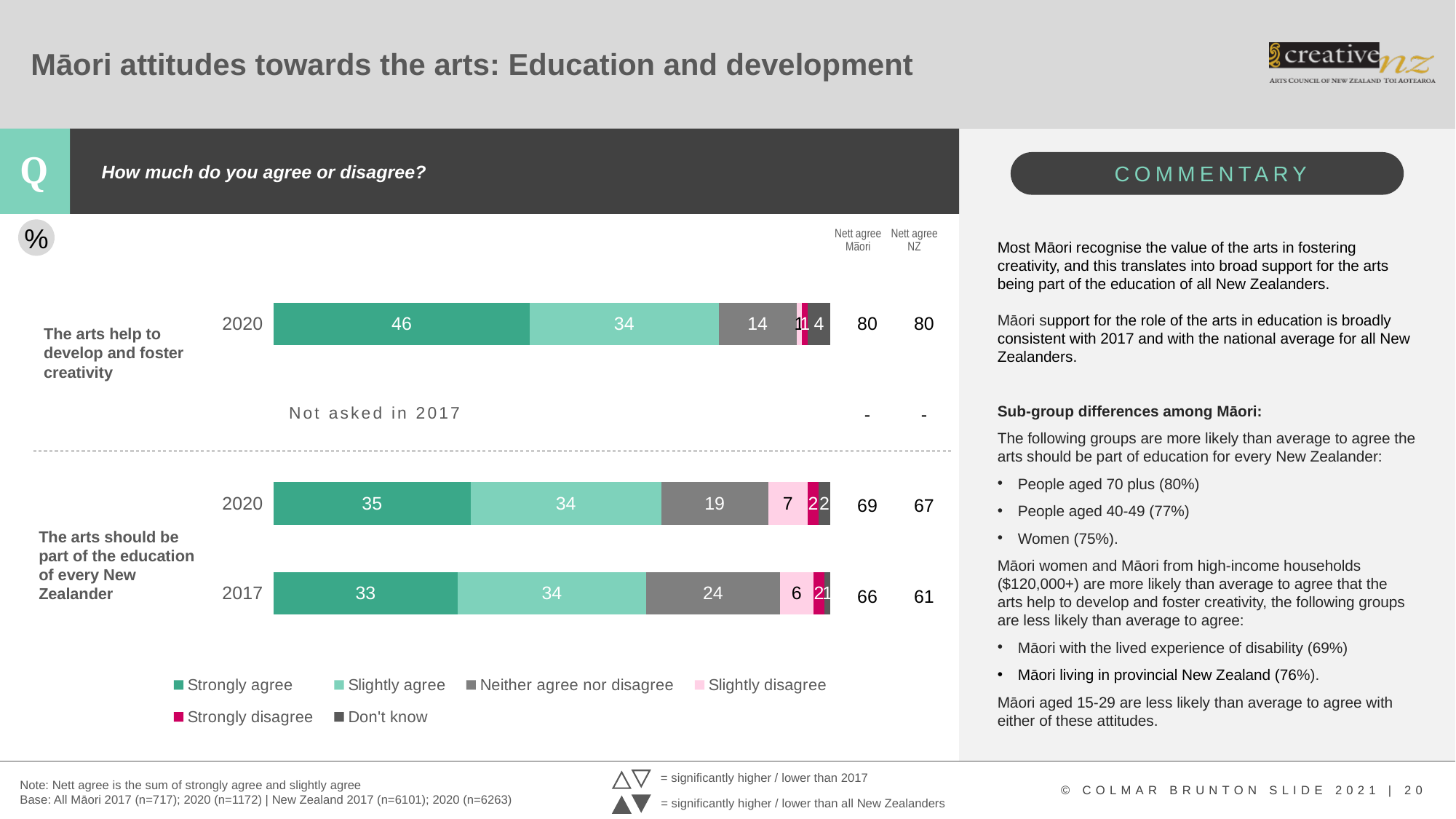
What is the 'Strongly agree' value for 'The arts help to develop and foster creativity' in 2020? 46 What is the Nett agree NZ figure for 'The arts should be part of the education of every New Zealander' in 2017? 61 How many series does the legend list? 6 What is the Nett agree Māori figure for 'The arts help to develop and foster creativity' in 2020? 80 How did the 'Strongly agree' value for 'The arts should be part of the education of every New Zealander' change from 2017 to 2020? It rose from 33 to 35 Which bar has the highest 'Strongly agree' value? The arts help to develop and foster creativity, 2020 What does the note say about 'The arts help to develop and foster creativity' for 2017? Not asked in 2017 What is the difference between the 'Strongly agree' values for 'The arts should be part of the education of every New Zealander' in 2020 and 2017? 2 What type of chart is shown on the slide? Stacked bar chart What is the 'Slightly disagree' value for 'The arts should be part of the education of every New Zealander' in 2020? 7 What is the 'Neither agree nor disagree' value for 'The arts should be part of the education of every New Zealander' in 2017? 24 Is the 'Neither agree nor disagree' value larger in 2020 or 2017 for 'The arts should be part of the education of every New Zealander'? 2017